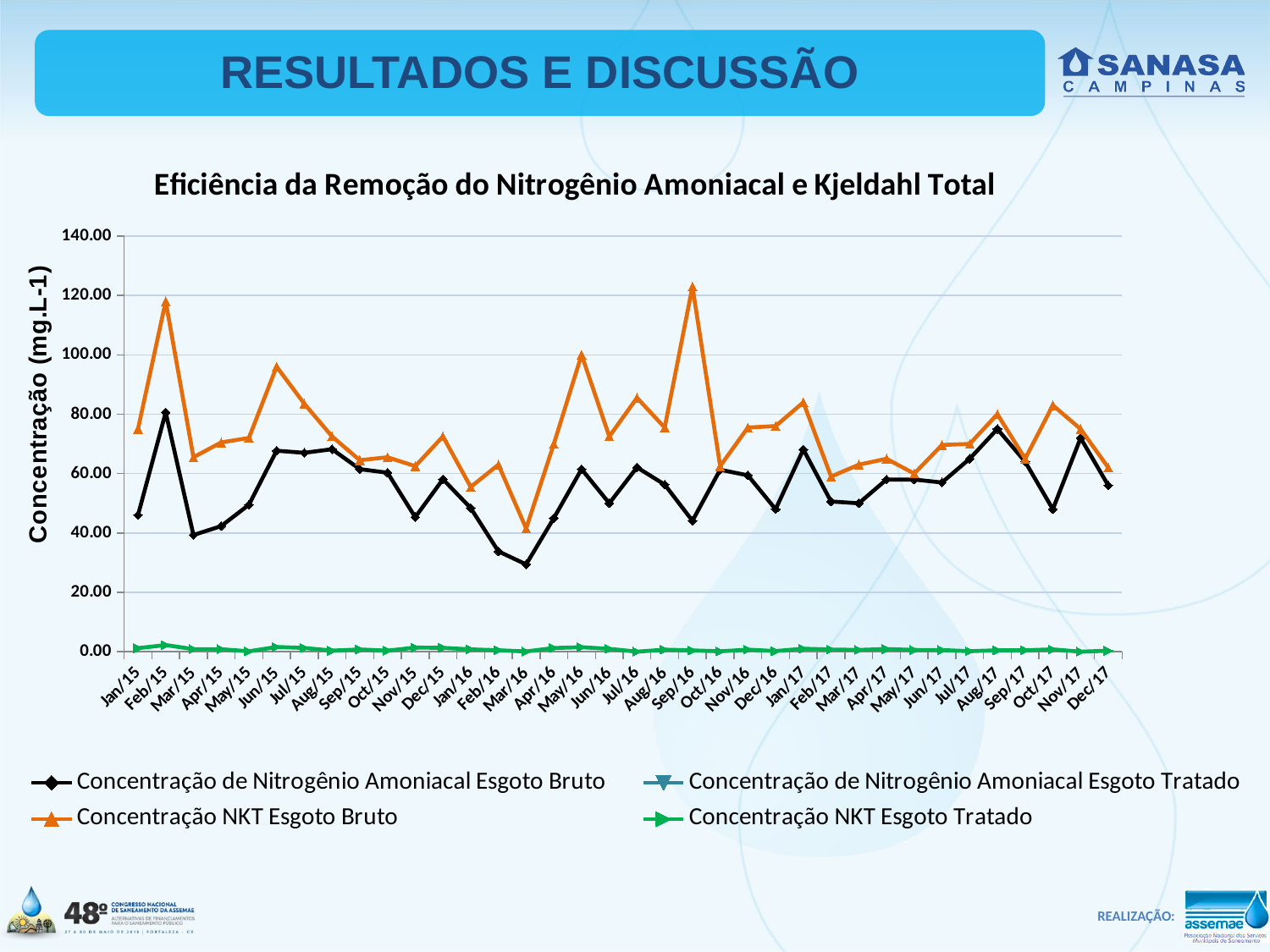
In which month does the Concentração de Nitrogênio Amoniacal Esgoto Bruto series reach its highest value? Feb/15 What kind of chart is shown on the slide? line chart Is the value for Concentração NKT Esgoto Bruto in Sep/16 greater or less than 120.00? greater In which month does the Concentração NKT Esgoto Bruto series reach its highest value? Sep/16 How many months are plotted along the x axis? 36 Is the value for Concentração de Nitrogênio Amoniacal Esgoto Bruto in Mar/16 greater or less than 40.00? less In Feb/15, which is larger: Concentração NKT Esgoto Bruto or Concentração de Nitrogênio Amoniacal Esgoto Bruto? Concentração NKT Esgoto Bruto Does the Concentração de Nitrogênio Amoniacal Esgoto Bruto series rise or fall from Jan/16 to Mar/16? fall What is the label of the y axis? Concentração (mg.L-1) In which month does the Concentração NKT Esgoto Bruto series reach its lowest value? Mar/16 In which month does the Concentração de Nitrogênio Amoniacal Esgoto Bruto series reach its lowest value? Mar/16 How many series does the legend list? 4